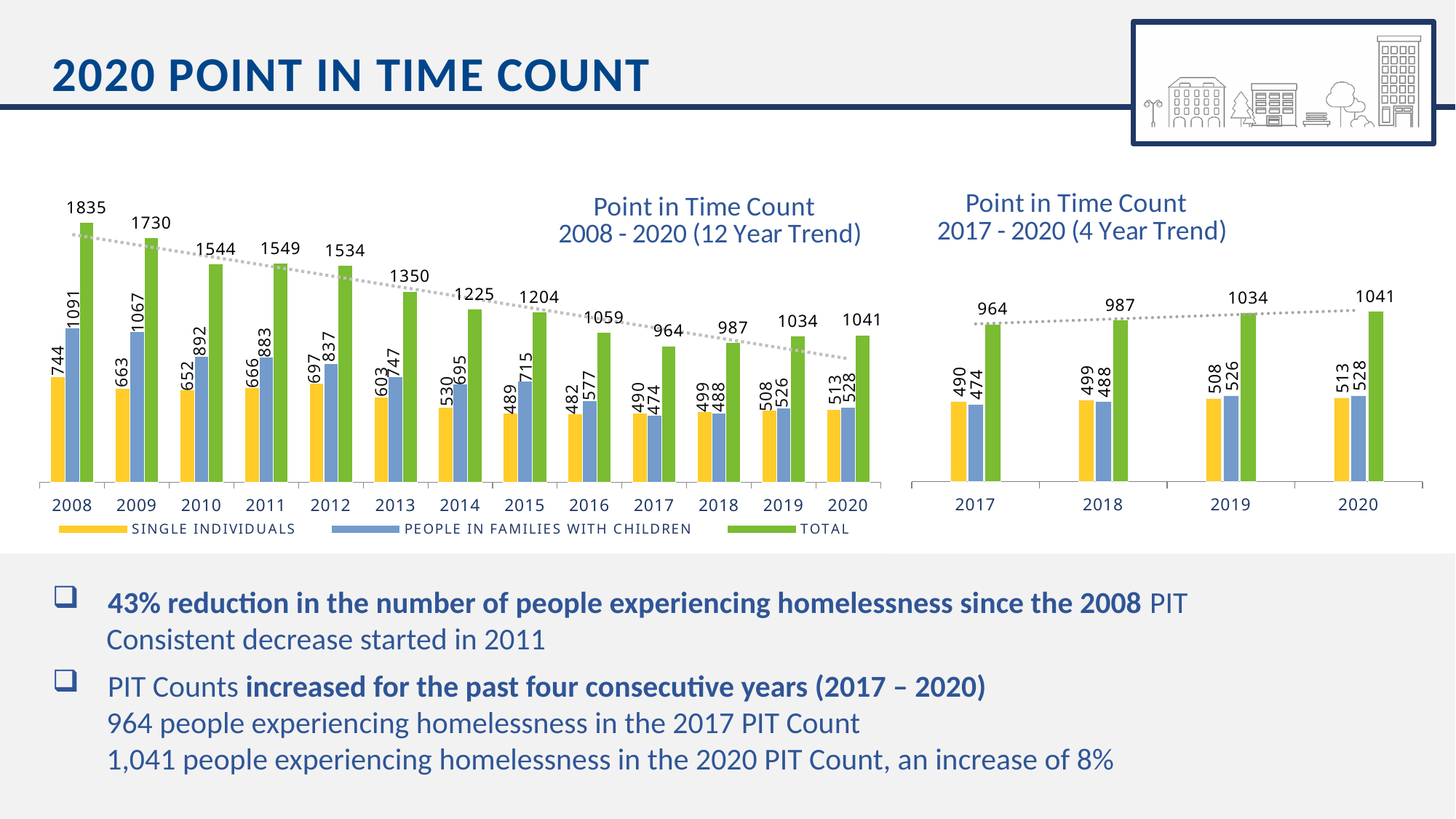
In the 'Point in Time Count 2017 - 2020 (4 Year Trend)' chart, does the Total rise or fall from 2017 to 2020? Rise In the 'Point in Time Count 2008 - 2020 (12 Year Trend)' chart, which year has the lowest Total? 2017 In the 'Point in Time Count 2008 - 2020 (12 Year Trend)' chart, what is the difference between the Total for 2008 and the Total for 2020? 794 What kind of chart is the 'Point in Time Count 2017 - 2020 (4 Year Trend)' chart? Bar chart In the 'Point in Time Count 2008 - 2020 (12 Year Trend)' chart, what is the People in Families with Children value for 2015? 715 In the 'Point in Time Count 2008 - 2020 (12 Year Trend)' chart, which year has the highest Total? 2008 How many series does the legend of the 'Point in Time Count 2008 - 2020 (12 Year Trend)' chart list? 3 In the 'Point in Time Count 2017 - 2020 (4 Year Trend)' chart, which is larger in 2019: Single Individuals or People in Families with Children? People in Families with Children In the 'Point in Time Count 2017 - 2020 (4 Year Trend)' chart, what is the difference between the Total for 2020 and the Total for 2017? 77 In the 'Point in Time Count 2008 - 2020 (12 Year Trend)' chart, what is the Total value for 2008? 1835 In the 'Point in Time Count 2008 - 2020 (12 Year Trend)' chart, how many years are shown on the x axis? 13 In the 'Point in Time Count 2008 - 2020 (12 Year Trend)' chart, what is the Single Individuals value for 2012? 697